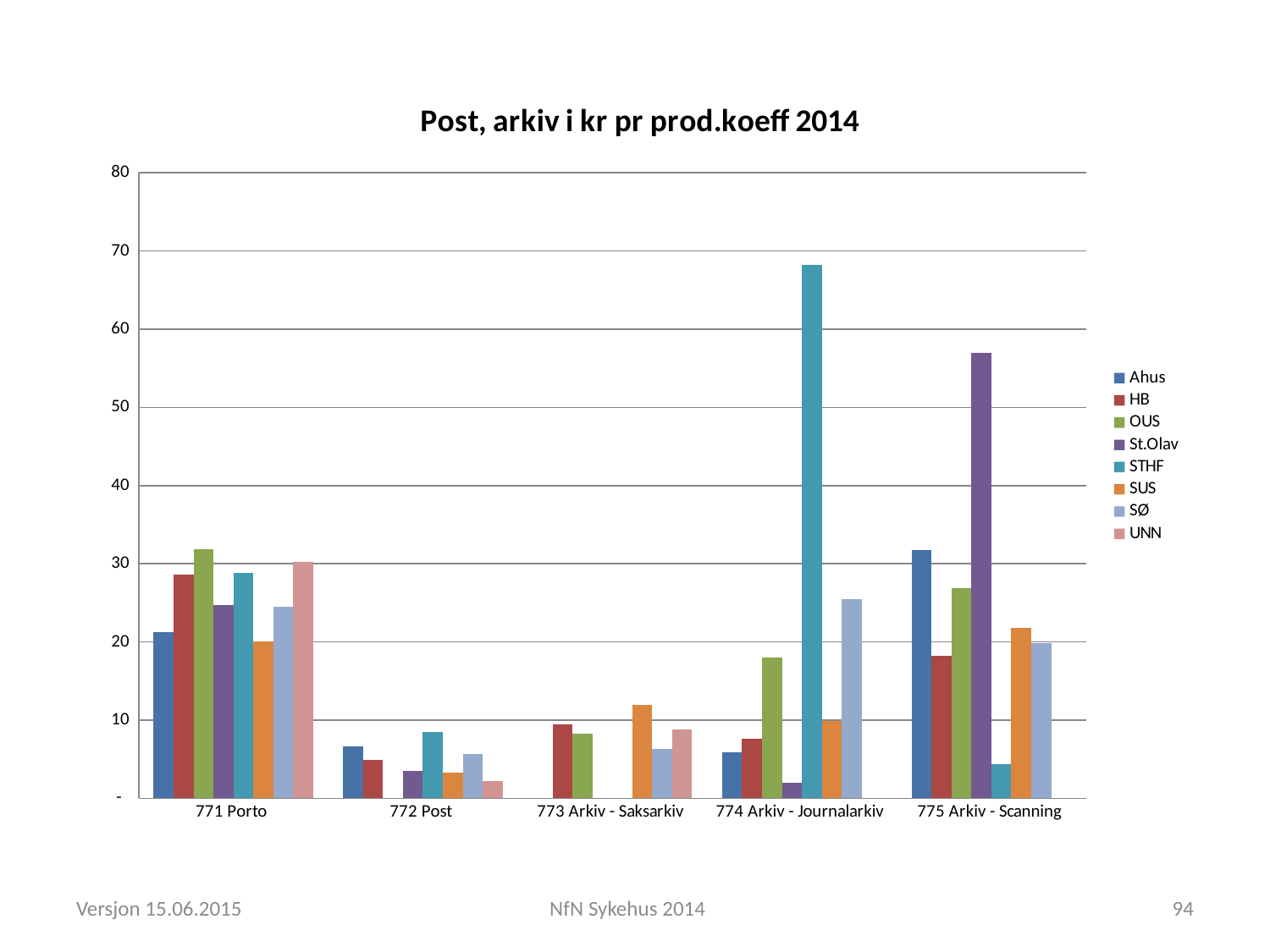
What kind of chart is shown on the slide? bar chart How many series does the legend list? 8 Which series has the highest value for 774 Arkiv - Journalarkiv? STHF Is the value for SUS in 773 Arkiv - Saksarkiv greater or less than 10? greater What is the title of the chart? Post, arkiv i kr pr prod.koeff 2014 Is the value for STHF in 774 Arkiv - Journalarkiv greater or less than 60? greater How many categories are shown on the x axis? 5 Is the value for STHF in 772 Post greater or less than 10? less Which is larger: STHF in 774 Arkiv - Journalarkiv or St.Olav in 775 Arkiv - Scanning? STHF in 774 Arkiv - Journalarkiv Which series has the highest value for 775 Arkiv - Scanning? St.Olav Which is larger for 774 Arkiv - Journalarkiv: OUS or SØ? SØ